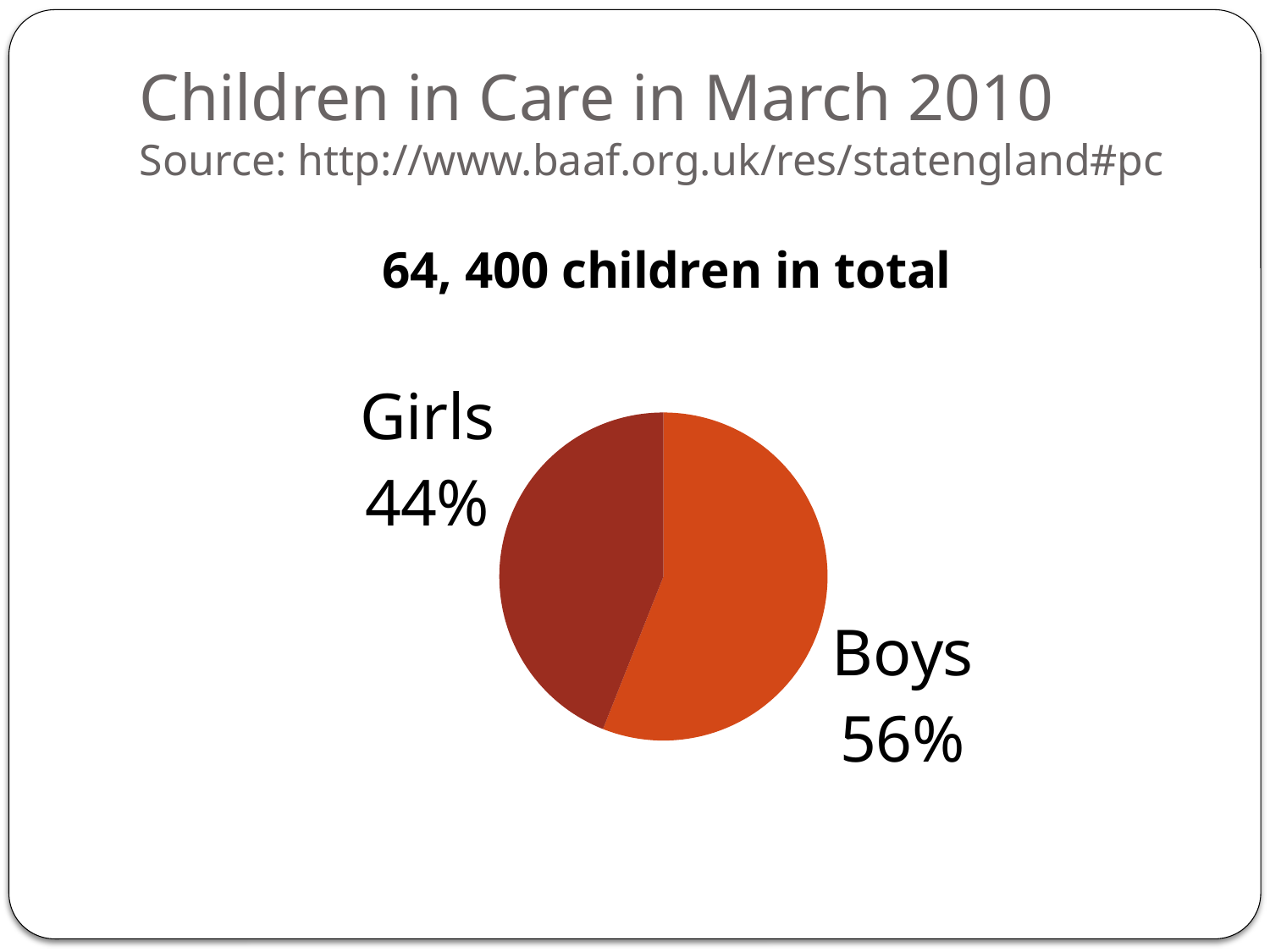
What kind of chart is shown on the slide? Pie chart Which slice of the pie chart is the darker colour? Girls Which slice of the pie chart is the smallest? Girls Which is larger, the Girls slice or the Boys slice? Boys What percentage of the pie chart is Boys? 56% What percentage of the pie chart is Girls? 44% What is the chart's title? 64, 400 children in total What share of the pie does the Boys slice represent? 56% Which slice of the pie chart is the largest? Boys What is the difference in percentage points between the Boys and Girls slices? 12 How many slices does the pie chart have? 2